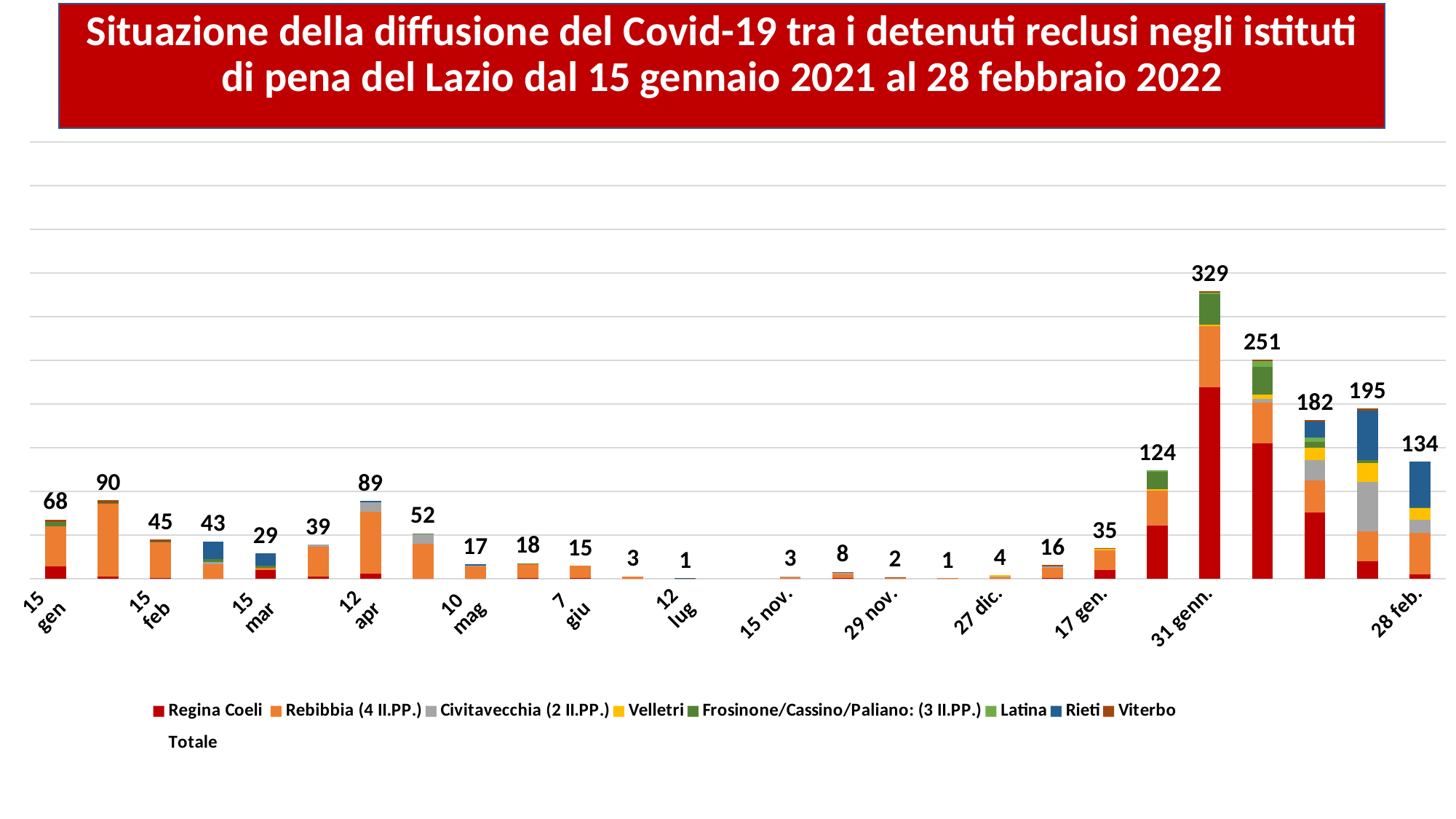
How many entries does the legend list? 9 Which date has the highest total? 31 genn. What kind of chart is shown on the slide? Stacked bar chart What is the total value shown for 28 feb.? 134 What is the total value shown for 15 gen? 68 Do the totals rise or fall from 15 gen to 15 mar? Fall What colour represents Regina Coeli in the legend? Red What is the total value shown for 31 genn.? 329 What is the total value shown for 12 apr? 89 What is the difference between the totals for 31 genn. and 28 feb.? 195 Which has a larger total, 15 gen or 15 feb? 15 gen How many bars are plotted in the chart? 26